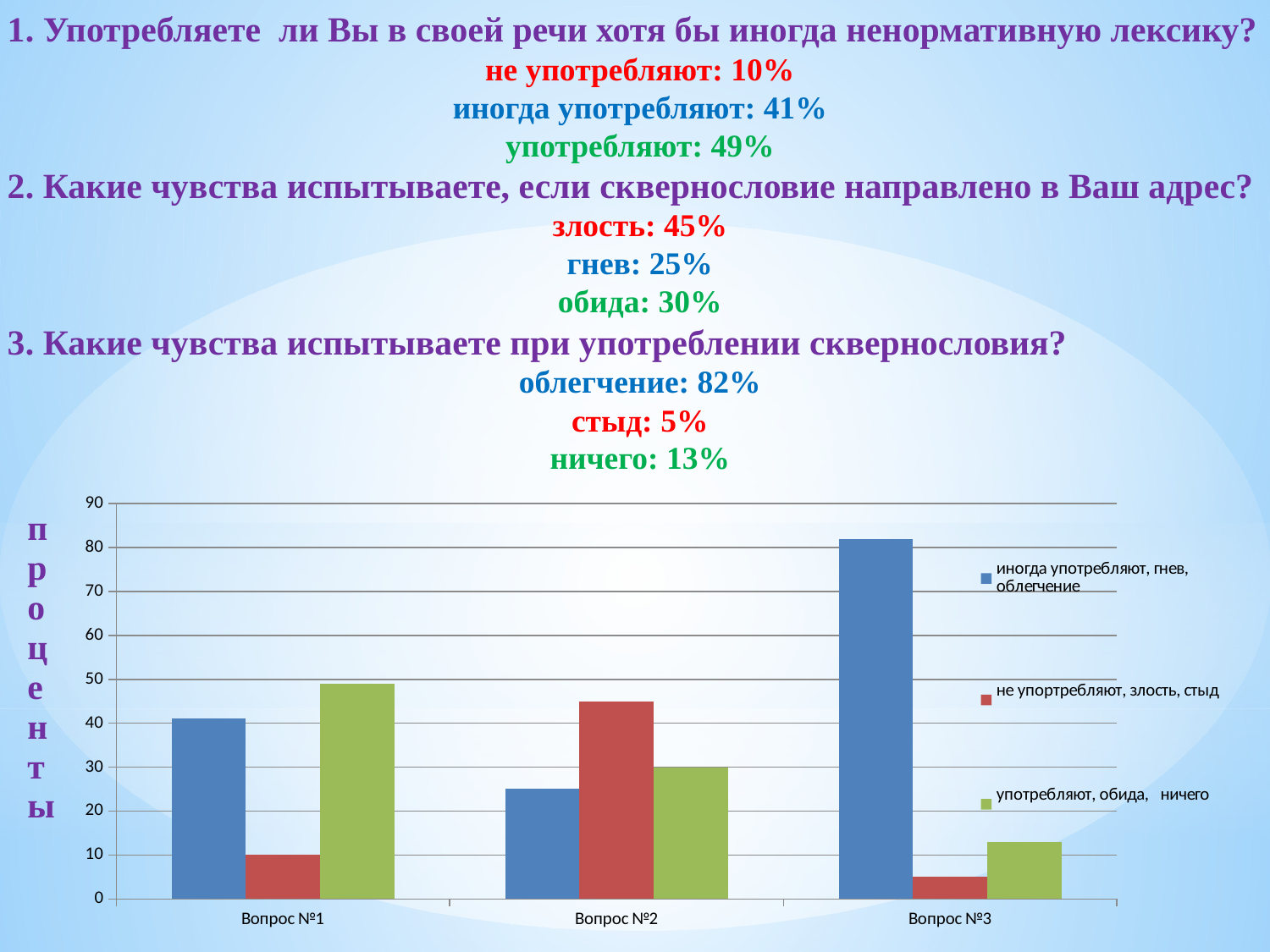
What kind of chart is shown on the slide? bar chart How many series does the chart legend list? 3 Is the value of the red bar for Вопрос №3 greater or less than 10? less For Вопрос №1, which is larger: the blue bar or the green bar? the green bar Which series has the lowest bar for Вопрос №3? не упортребляют, злость, стыд What is the difference between the green bar for Вопрос №2 and the red bar for Вопрос №1? 20 What is the value of the red bar (не упортребляют, злость, стыд) for Вопрос №1? 10 Is the value of the blue bar for Вопрос №3 greater or less than 80? greater What is the label on the vertical axis of the chart? проценты What is the value of the green bar (употребляют, обида, ничего) for Вопрос №2? 30 Which category contains the tallest bar in the chart? Вопрос №3 How many categories are shown on the x axis of the chart? 3